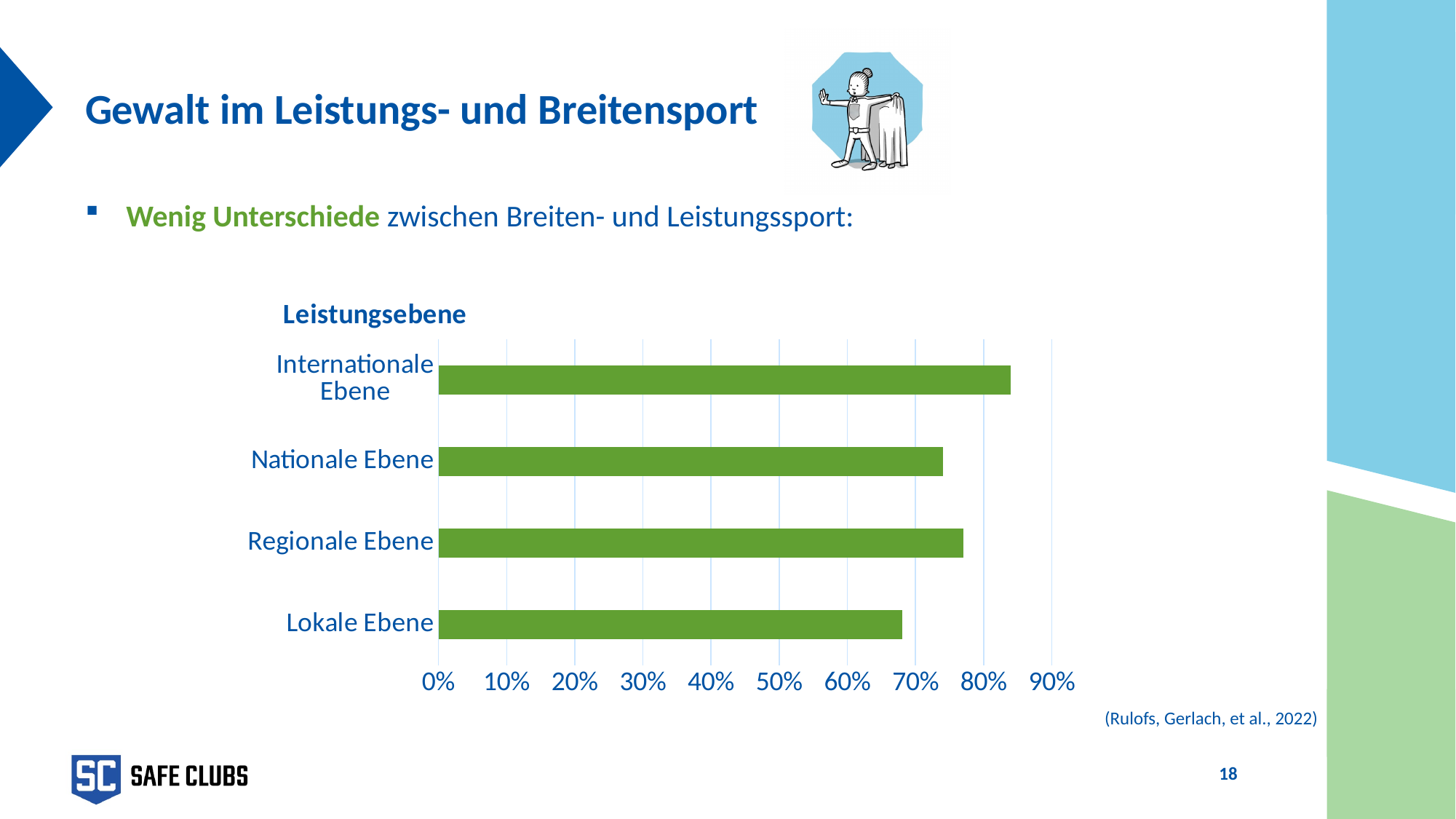
What kind of chart is shown on the slide? bar chart Is the value for Regionale Ebene greater or less than 80%? less Which category has the highest value in the chart? Internationale Ebene Is the value for Lokale Ebene greater or less than 70%? less What colour are the bars in the chart? green Is the value for Internationale Ebene greater or less than 80%? greater Which is larger, the value for Regionale Ebene or the value for Lokale Ebene? Regionale Ebene Which is larger, the value for Internationale Ebene or the value for Lokale Ebene? Internationale Ebene What is the title of the chart? Leistungsebene How many categories (Leistungsebenen) are plotted in the chart? 4 Which category has the lowest value in the chart? Lokale Ebene